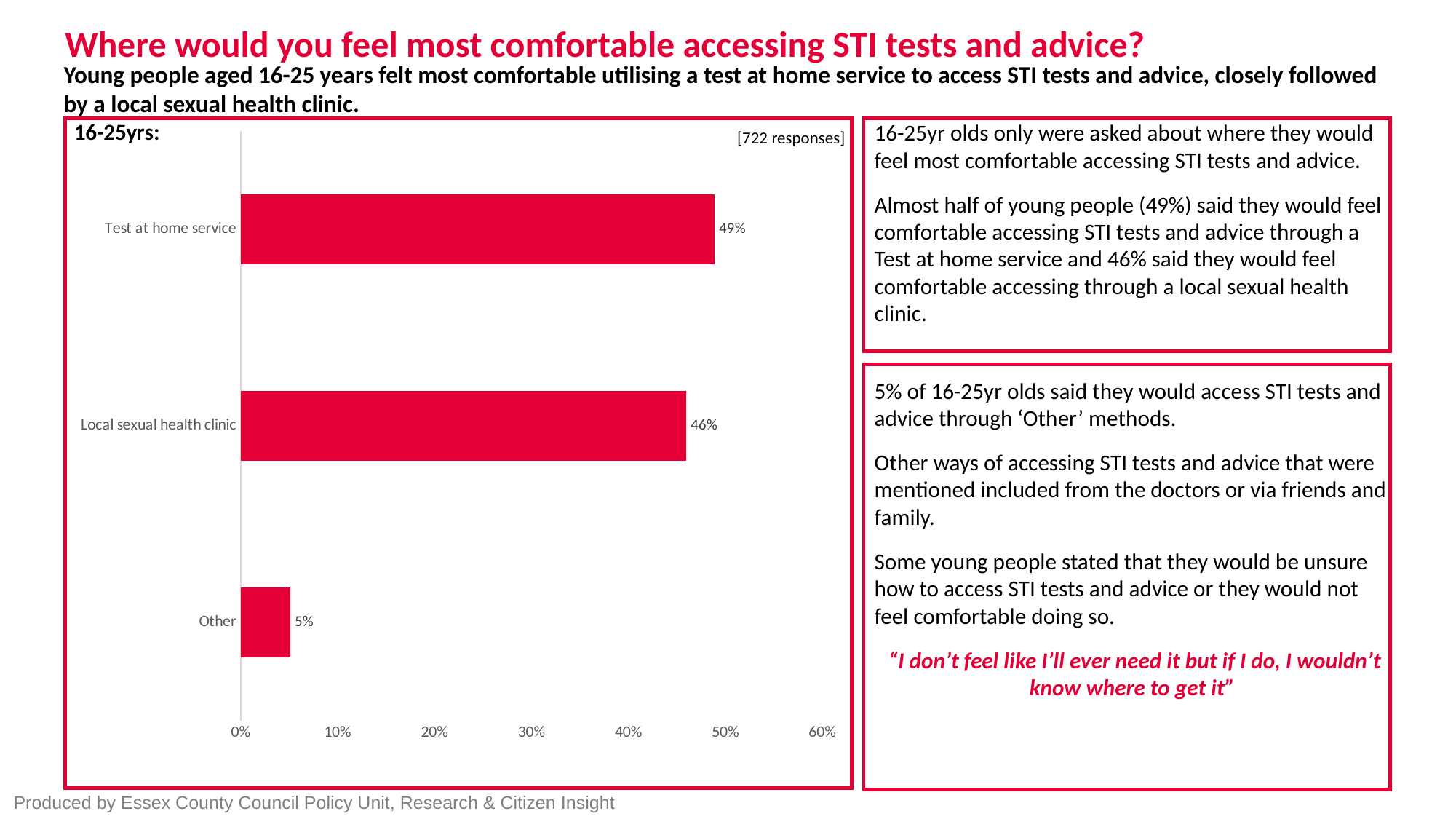
What is the difference in percentage points between 'Test at home service' and 'Local sexual health clinic'? 3 percentage points What type of chart is shown on the slide? Bar chart How many responses does the chart say it is based on? 722 responses What is the difference between the 'Local sexual health clinic' value and the 'Other' value? 41 percentage points What is the value shown for 'Local sexual health clinic'? 46% Which category has the highest value in the chart? Test at home service How many categories are shown in the chart? 3 Which category has the lowest value in the chart? Other Is the value for 'Other' greater or less than 10%? less Which is larger: the value for 'Local sexual health clinic' or the value for 'Other'? Local sexual health clinic What percentage of 16-25 year olds said they would feel most comfortable using a test at home service? 49% What percentage is shown for the 'Other' category? 5%